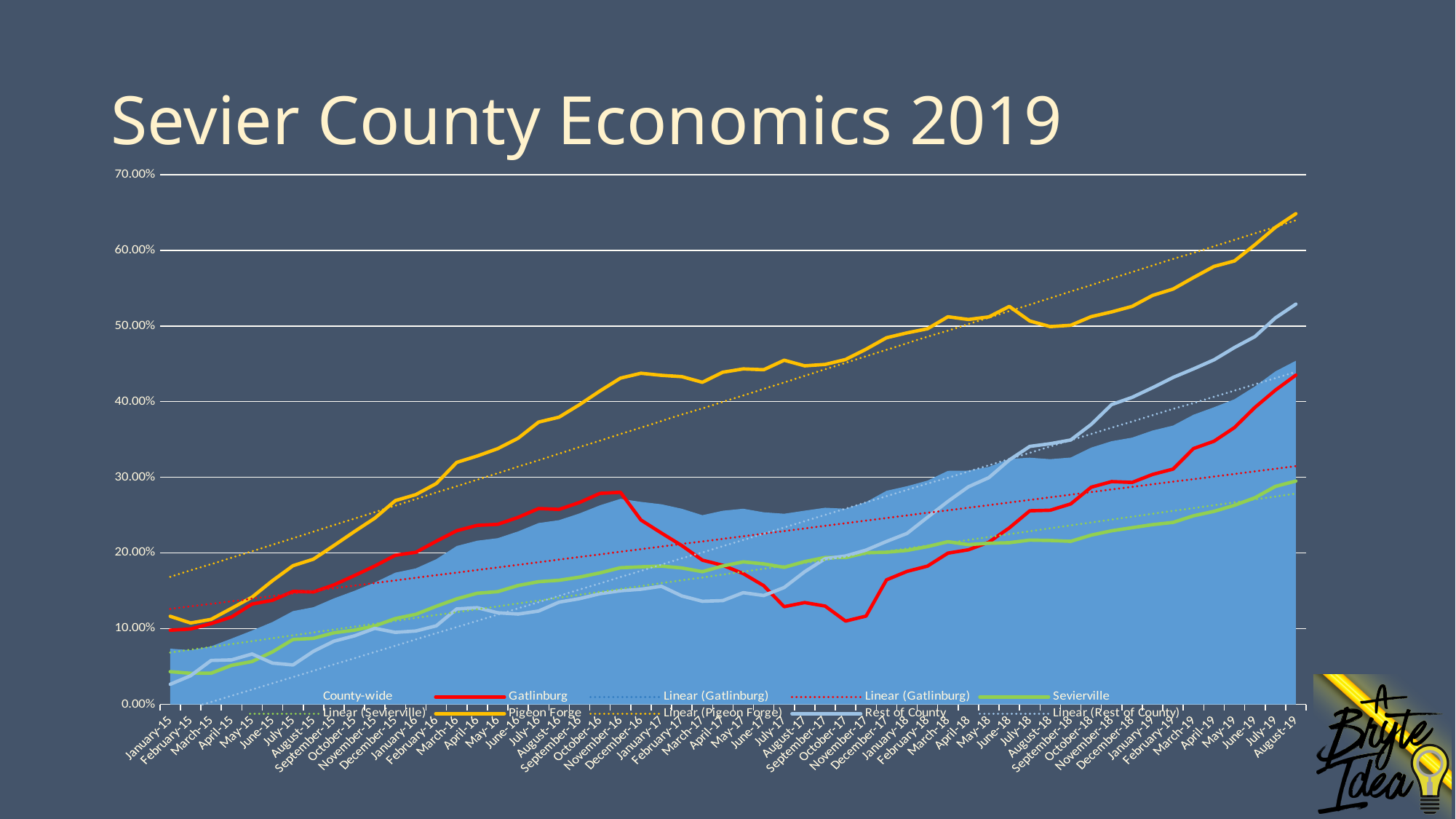
At August-19, which is larger: Pigeon Forge or Gatlinburg? Pigeon Forge Is the Pigeon Forge value at January-15 greater or less than 20.00%? less What is the title shown above the chart? Sevier County Economics 2019 Which of the plotted lines has the lowest value at August-19? Sevierville How many months are plotted along the x axis, from January-15 to August-19? 56 At October-17, which is larger: Gatlinburg or Sevierville? Sevierville Is the Rest of County value at August-19 greater or less than 50.00%? greater Is the Pigeon Forge value at August-19 greater or less than 60.00%? greater Does the Pigeon Forge line generally rise or fall from January-15 to August-19? rise How many entries does the chart legend list? 10 Which series has the highest value at August-19? Pigeon Forge